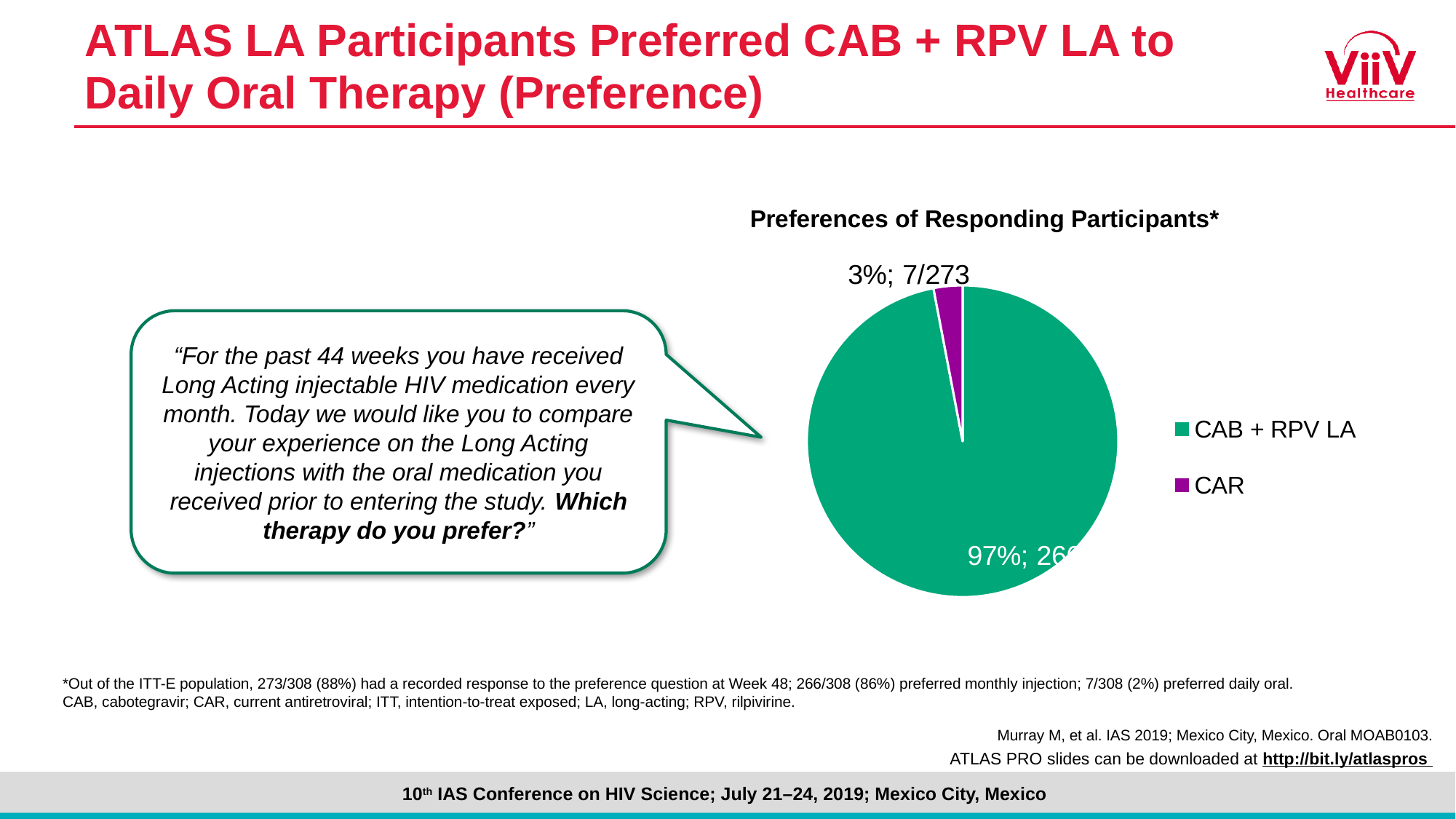
What is the title of the pie chart? Preferences of Responding Participants* What percentage of responding participants preferred CAB + RPV LA? 97% How many categories does the pie chart show? 2 What is the difference in percentage points between the CAB + RPV LA slice and the CAR slice? 94 percentage points What kind of chart is shown under the title "Preferences of Responding Participants*"? pie chart Which slice is larger, CAB + RPV LA or CAR? CAB + RPV LA How many responding participants preferred CAR, as shown on the pie chart label? 7/273 Which category has the largest slice of the pie chart? CAB + RPV LA What colour is the CAR slice in the pie chart? purple What percentage of responding participants preferred CAR? 3% Which category has the smallest slice of the pie chart? CAR How many entries does the pie chart legend list? 2